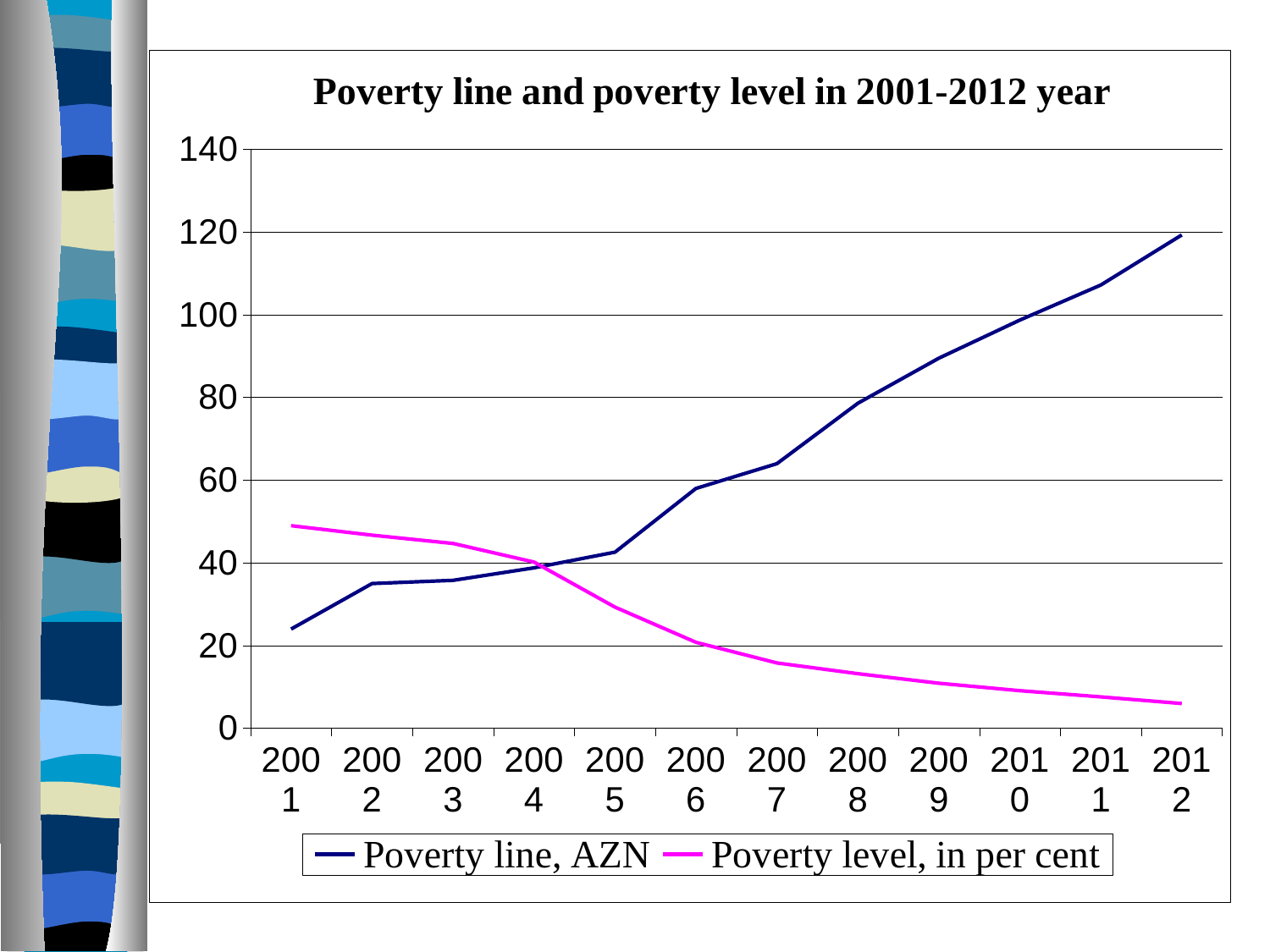
In 2001, which series has the larger value: Poverty line, AZN or Poverty level, in per cent? Poverty level, in per cent Does the Poverty level, in per cent series rise or fall from 2001 to 2012? fall How many series does the legend list? 2 What is the title of the chart? Poverty line and poverty level in 2001-2012 year In which year is the Poverty level, in per cent value lowest? 2012 In which year is the Poverty line, AZN value highest? 2012 What kind of chart is shown on the slide? line chart In which year is the Poverty level, in per cent value highest? 2001 How many years are plotted along the x axis? 12 Is the Poverty level, in per cent value for 2012 greater or less than 20? less Does the Poverty line, AZN series rise or fall from 2001 to 2012? rise Is the Poverty line, AZN value for 2012 greater or less than 100? greater